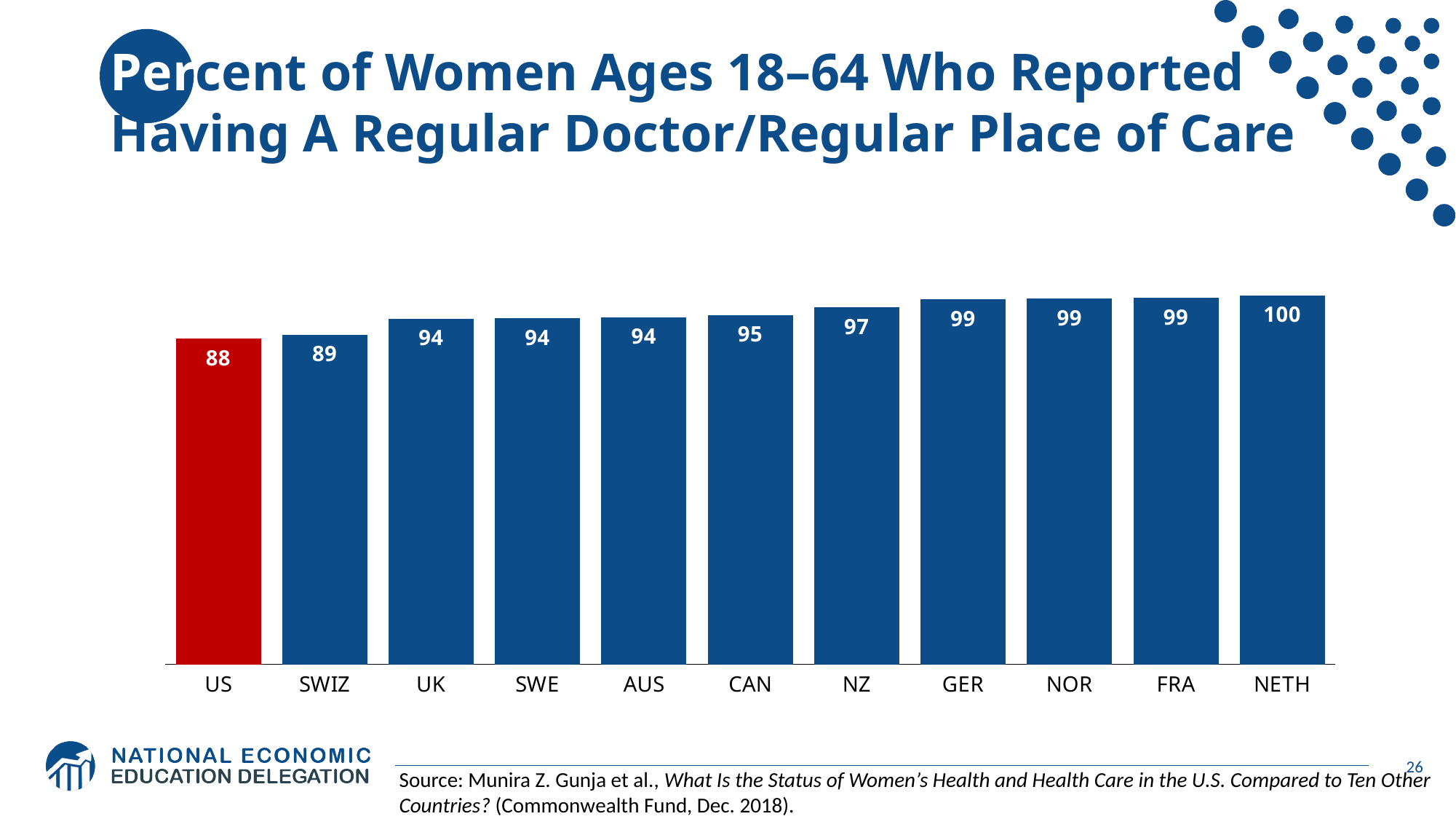
What is the difference between the values for NETH and the US? 12 Which country has the highest value? NETH What is the value for the US? 88 What is the difference between the values for SWIZ and UK? 5 Do the values rise or fall from left to right across the chart? rise What is the value for CAN? 95 Which country has the lowest value? US Which has a larger value, SWIZ or CAN? CAN Which bar is coloured red rather than blue? US What kind of chart is shown on the slide? bar chart How many countries are shown in the chart? 11 What is the value for NZ? 97